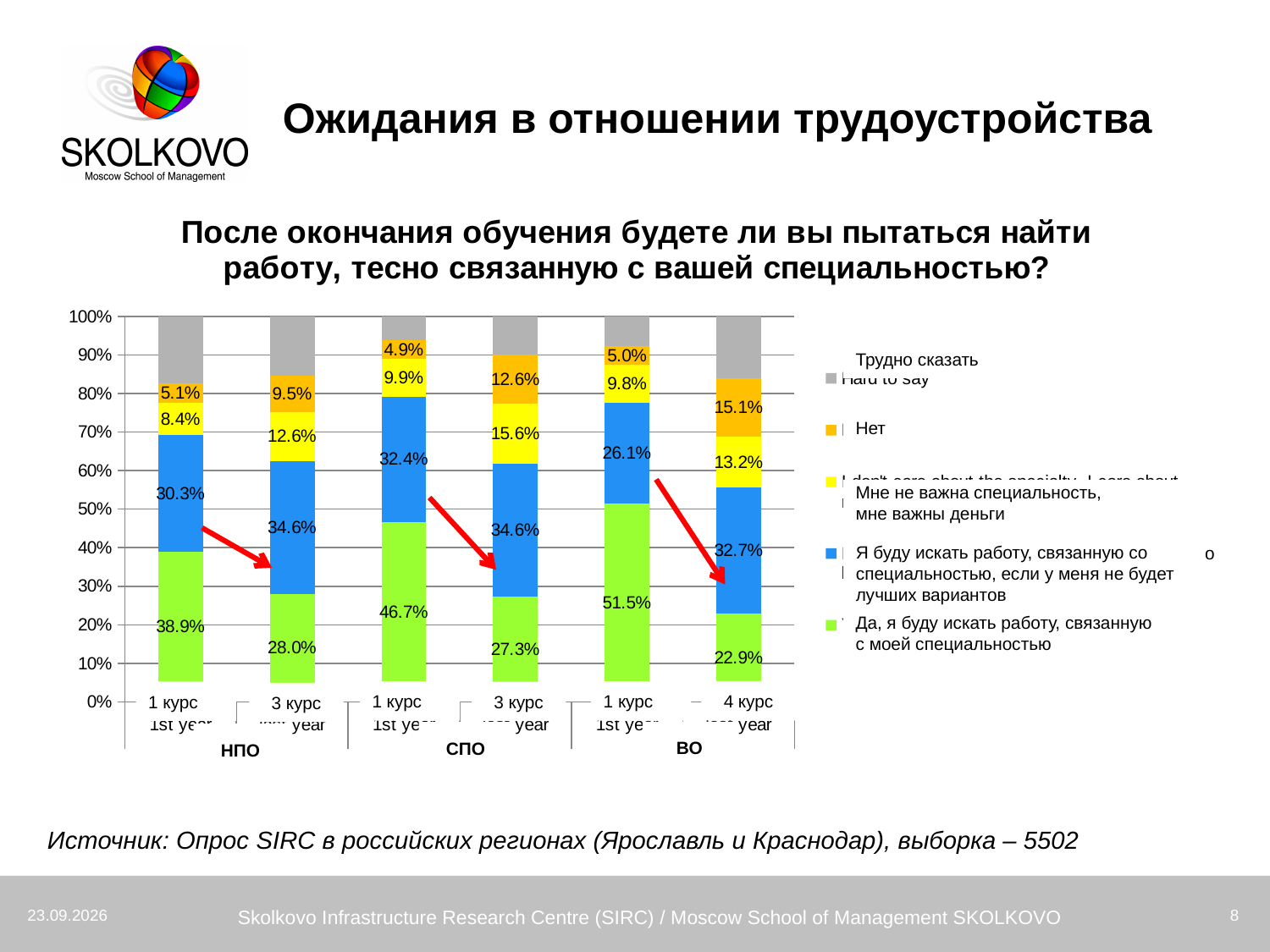
What is the share of 'Да, я буду искать работу, связанную с моей специальностью' for ВО 1 курс? 51.5% Which is larger: the 'Нет' share for НПО 3 курс or for СПО 3 курс? СПО 3 курс What is the share of 'Нет' for ВО 4 курс? 15.1% How many series does the legend list? 5 What kind of chart is shown on the slide? stacked bar chart Within each education level, does the 'Да, я буду искать работу, связанную с моей специальностью' share rise or fall from the first year to the later year? fall Which bar has the highest share of 'Да, я буду искать работу, связанную с моей специальностью'? ВО 1 курс What is the share of 'Я буду искать работу, связанную со специальностью, если у меня не будет лучших вариантов' for НПО 1 курс? 30.3% Which bar has the lowest share of 'Да, я буду искать работу, связанную с моей специальностью'? ВО 4 курс What is the difference between the 'Да' share for СПО 1 курс and СПО 3 курс? 19.4% How many bars (student groups) are plotted in the chart? 6 What is the share of 'Мне не важна специальность, мне важны деньги' for СПО 3 курс? 15.6%